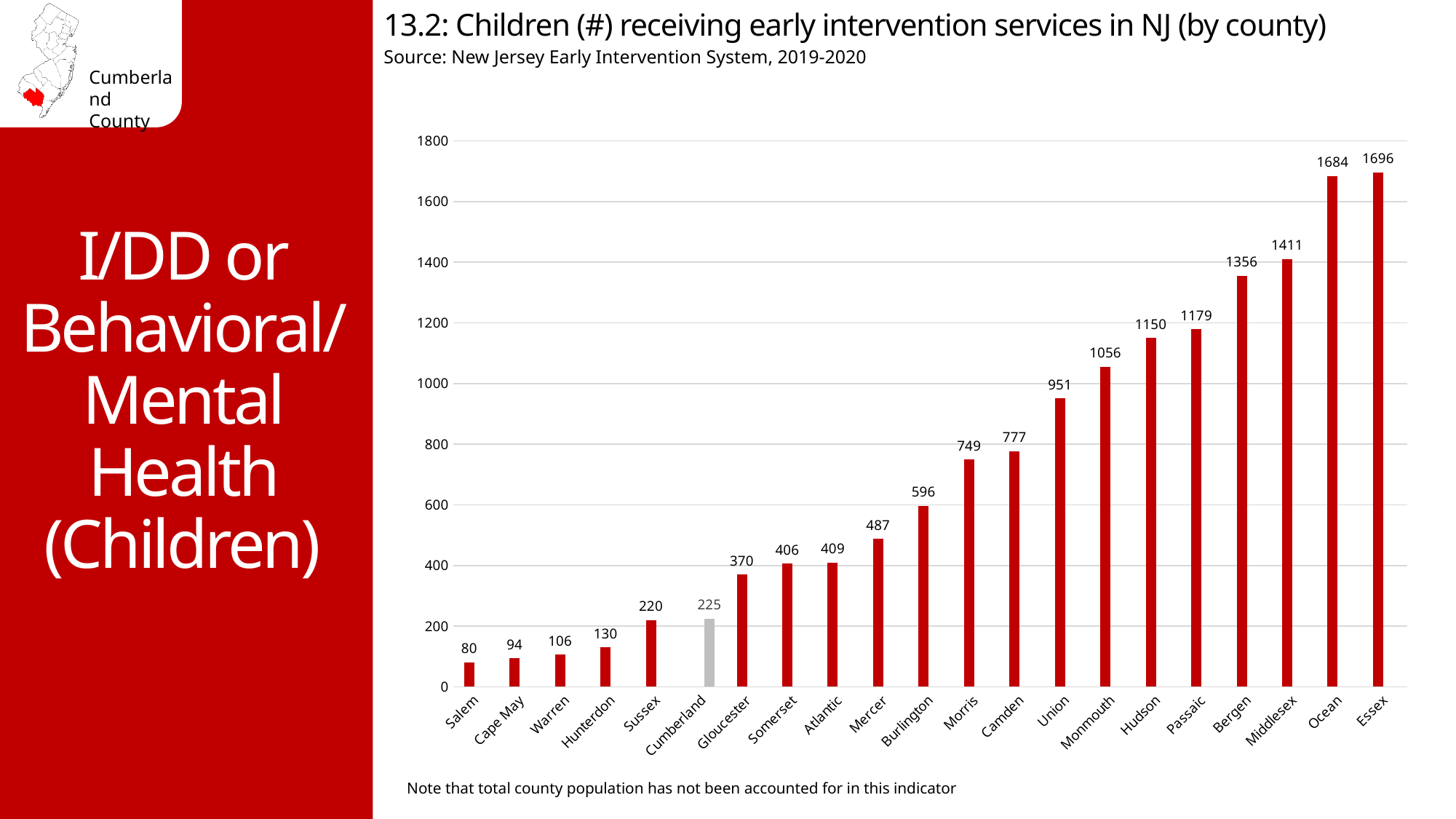
Is the value for Hudson greater or less than 1000? greater Which county's bar is shown in gray instead of red? Cumberland What is the value shown for Mercer County? 487 Which county has the highest number of children receiving early intervention services? Essex Which county has the lowest number of children receiving early intervention services? Salem What is the value shown for Essex County? 1696 Which county has a larger value, Union or Camden? Union How many counties are shown on the chart? 21 What is the difference between the values for Cumberland and Sussex? 5 What is the difference between the values for Ocean and Middlesex? 273 What kind of chart is shown on the slide? Bar chart How many children received early intervention services in Cumberland County? 225